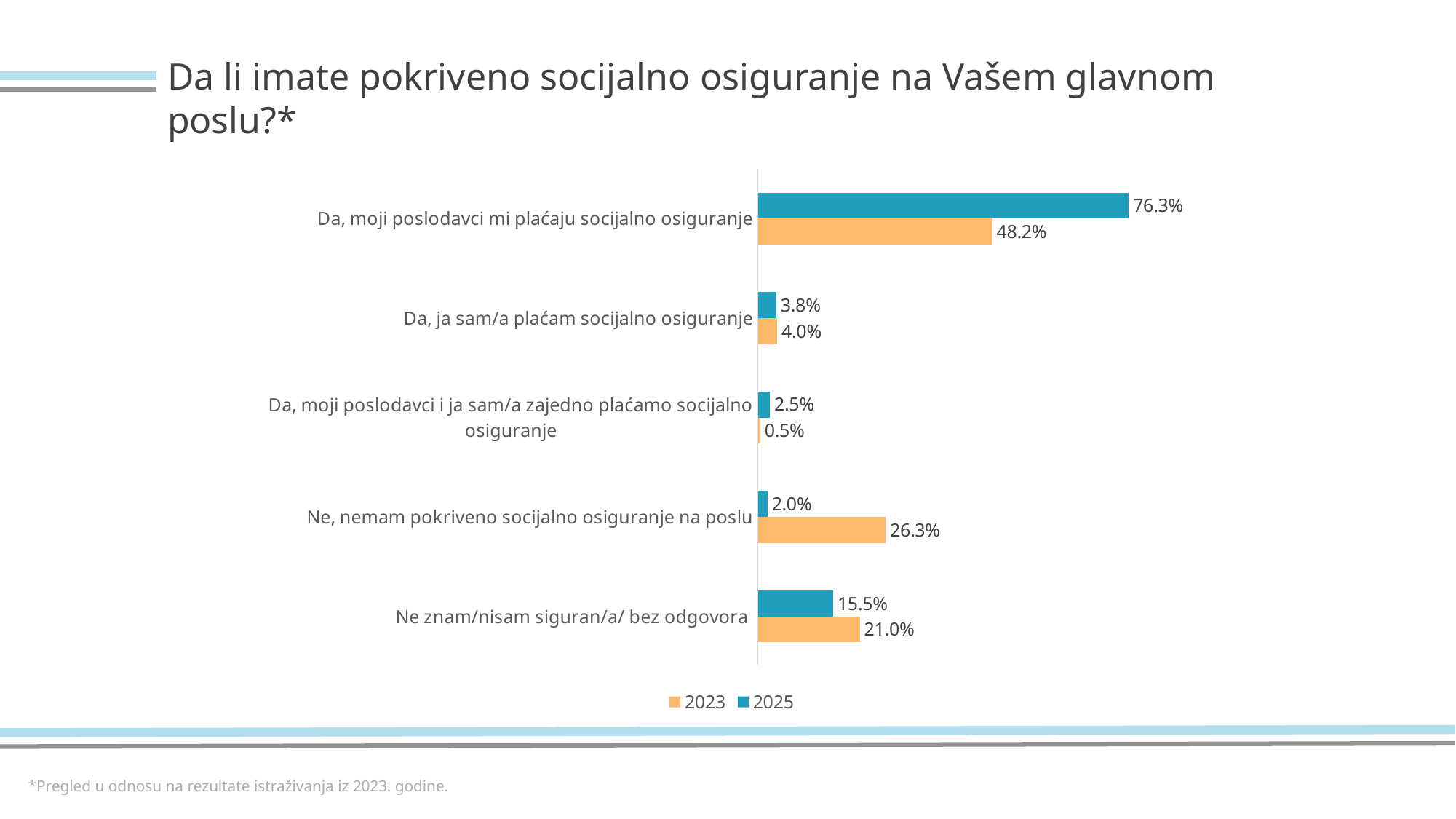
What is the 2023 value for "Da, ja sam/a plaćam socijalno osiguranje"? 4.0% What is the 2023 value for "Ne, nemam pokriveno socijalno osiguranje na poslu"? 26.3% Which is larger for "Ne znam/nisam siguran/a/ bez odgovora": the 2023 value or the 2025 value? 2023 What is the 2025 value for "Ne znam/nisam siguran/a/ bez odgovora"? 15.5% Which category has the highest 2025 value? Da, moji poslodavci mi plaćaju socijalno osiguranje What kind of chart is shown on the slide? Bar chart What is the difference between the 2023 and 2025 values for "Ne, nemam pokriveno socijalno osiguranje na poslu"? 24.3% What is the difference between the 2025 and 2023 values for "Da, moji poslodavci mi plaćaju socijalno osiguranje"? 28.1% How many categories are shown in the chart? 5 What is the 2025 value for "Da, moji poslodavci mi plaćaju socijalno osiguranje"? 76.3% Which category has the lowest 2023 value? Da, moji poslodavci i ja sam/a zajedno plaćamo socijalno osiguranje How many series does the legend list? 2